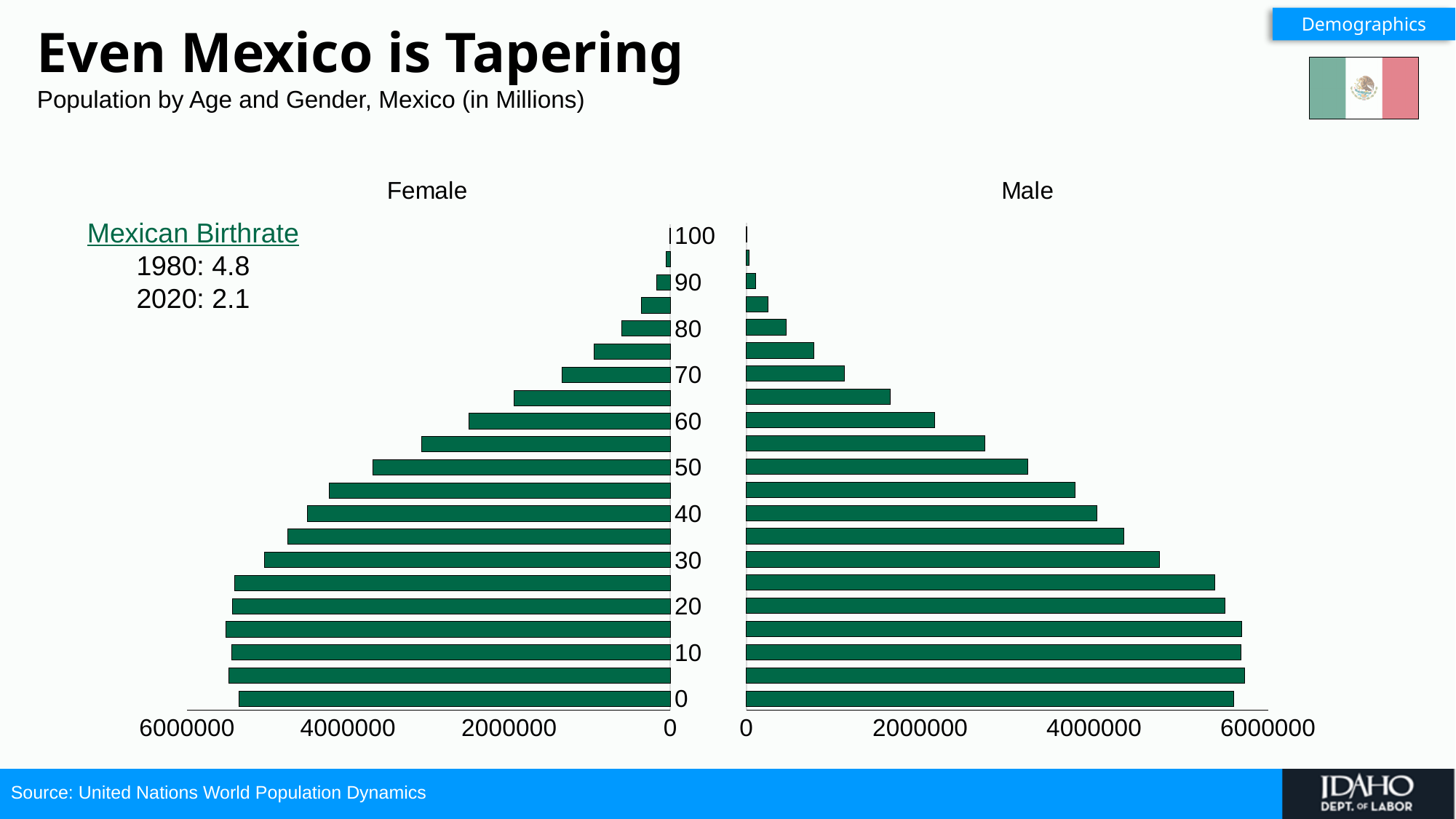
On the Female side of the chart, is the value for age 60 greater or less than 2000000? greater What kind of chart is shown on the slide? Bar chart (population pyramid) On the Female side of the chart, which age group has the smallest population? 100 On the Female side of the chart, which is larger, the bar for age 20 or the bar for age 60? Age 20 How many age labels are printed on the vertical axis of the chart? 11 On the Male side of the chart, is the value for age 80 greater or less than 2000000? less On the Female side of the chart, is the value for age 30 greater or less than 4000000? greater Moving from age 30 up to age 100, do the bars on the Male side get longer or shorter? Shorter On the Male side of the chart, which is larger, the bar for age 10 or the bar for age 70? Age 10 What is the subtitle describing the chart? Population by Age and Gender, Mexico (in Millions)